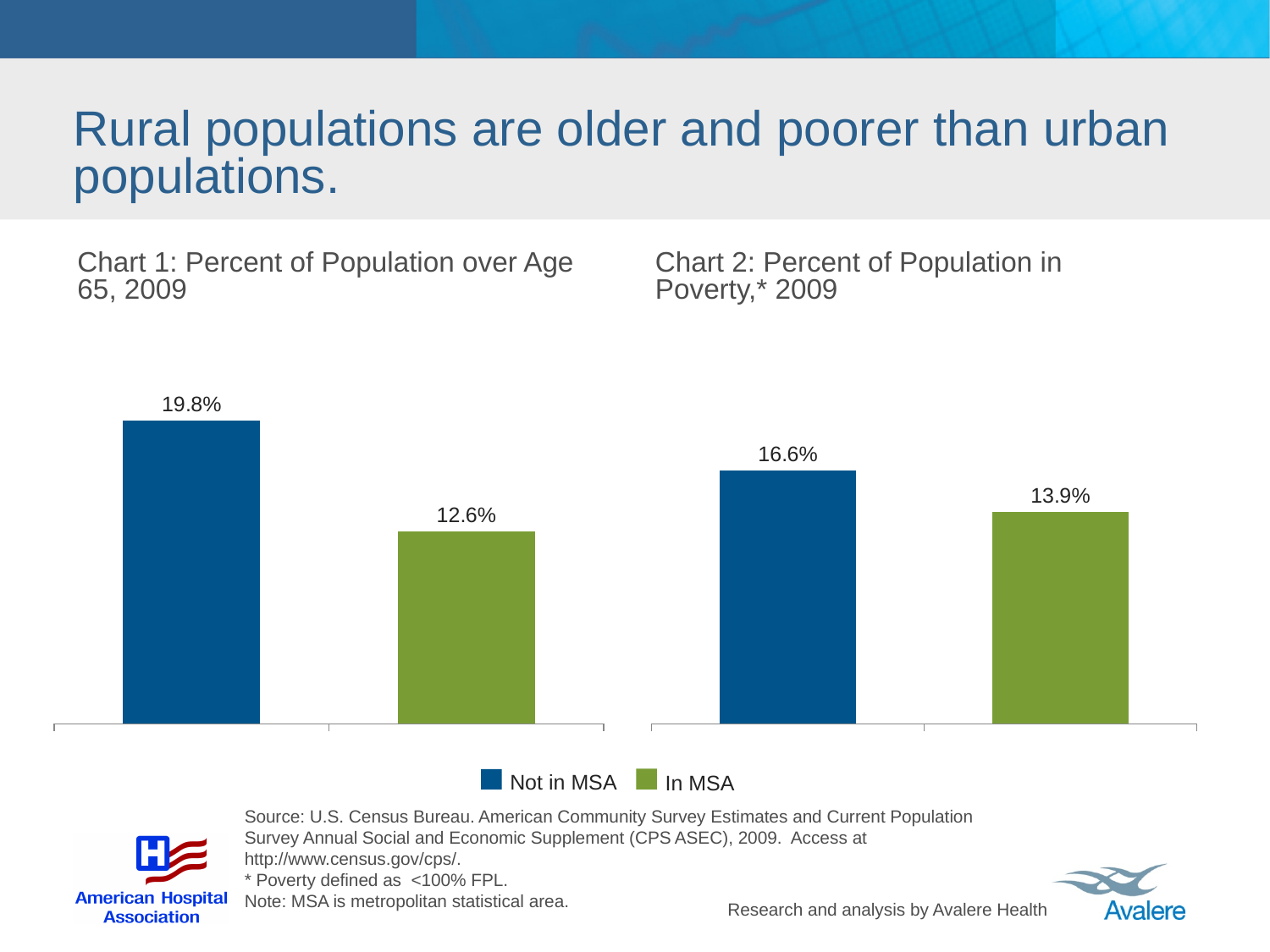
In Chart 2 (Percent of Population in Poverty, 2009), what is the value for Not in MSA? 16.6% In Chart 2 (Percent of Population in Poverty, 2009), which series has the lower value? In MSA In Chart 1 (Percent of Population over Age 65, 2009), what is the value for Not in MSA? 19.8% In Chart 1 (Percent of Population over Age 65, 2009), which series has the higher value? Not in MSA What kind of chart is Chart 1 (Percent of Population over Age 65, 2009)? bar chart In Chart 1 (Percent of Population over Age 65, 2009), what is the value for In MSA? 12.6% How many series does the shared legend list? 2 In Chart 2 (Percent of Population in Poverty, 2009), is the value for Not in MSA larger or smaller than the value for In MSA? larger In Chart 1 (Percent of Population over Age 65, 2009), what is the difference between the Not in MSA and In MSA values? 7.2% In Chart 2 (Percent of Population in Poverty, 2009), what is the value for In MSA? 13.9% Which colour represents In MSA in the legend? green In Chart 2 (Percent of Population in Poverty, 2009), what is the difference between the Not in MSA and In MSA values? 2.7%